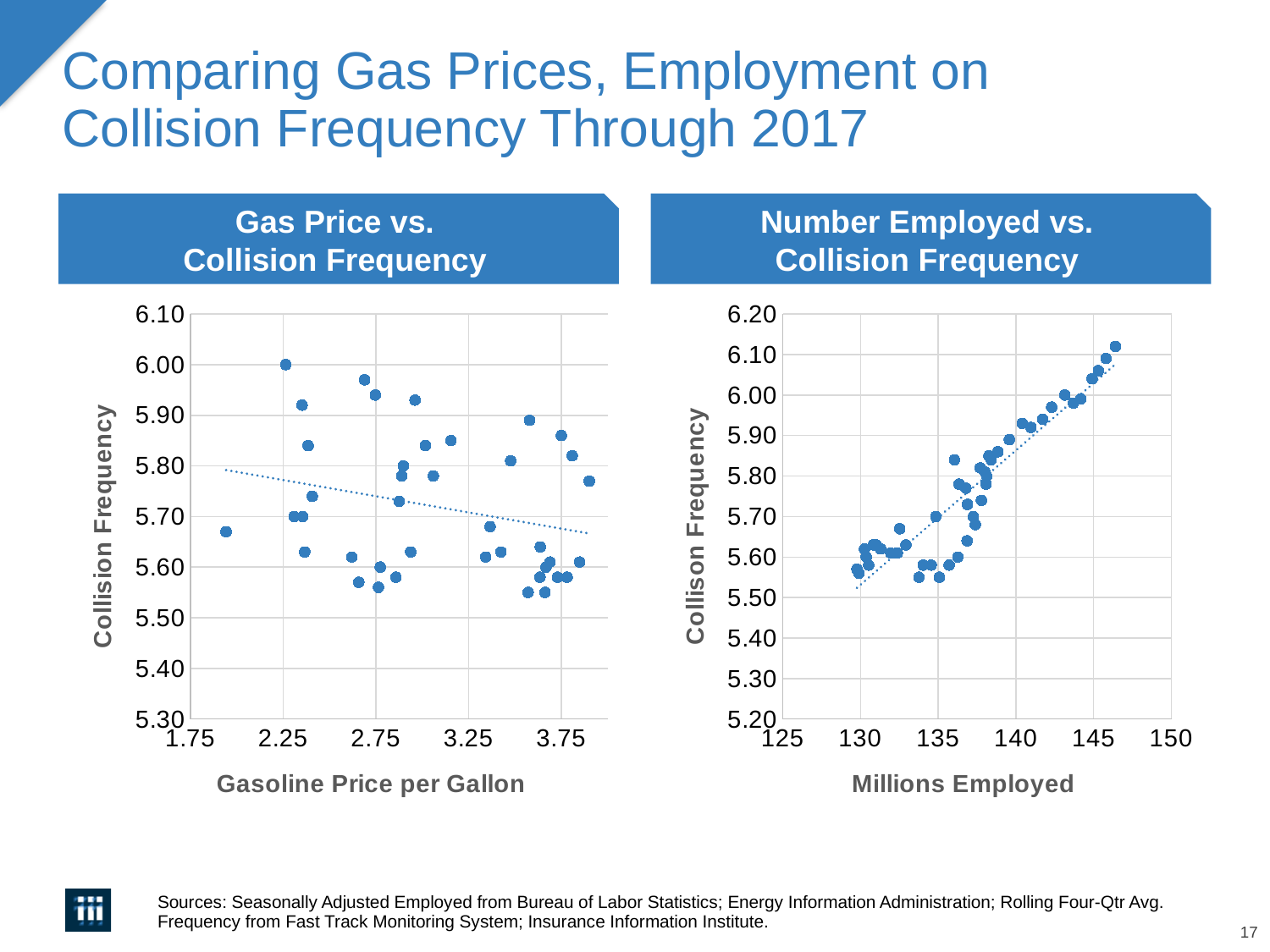
In the "Number Employed vs. Collision Frequency" chart, is the lowest collision frequency plotted greater or less than 5.60? less In the "Gas Price vs. Collision Frequency" chart, is the lowest collision frequency plotted greater or less than 5.60? less What is the x-axis label of the "Number Employed vs. Collision Frequency" chart? Millions Employed What kind of chart is the "Gas Price vs. Collision Frequency" chart? scatter chart What kind of chart is the "Number Employed vs. Collision Frequency" chart? scatter chart In the "Gas Price vs. Collision Frequency" chart, is the highest collision frequency plotted greater or less than 5.90? greater In the "Number Employed vs. Collision Frequency" chart, what is the highest value shown on the x axis? 150 In the "Gas Price vs. Collision Frequency" chart, does the dotted trend line rise or fall as gasoline price per gallon increases? fall In the "Number Employed vs. Collision Frequency" chart, does collision frequency rise or fall as millions employed increases? rise What is the x-axis label of the "Gas Price vs. Collision Frequency" chart? Gasoline Price per Gallon